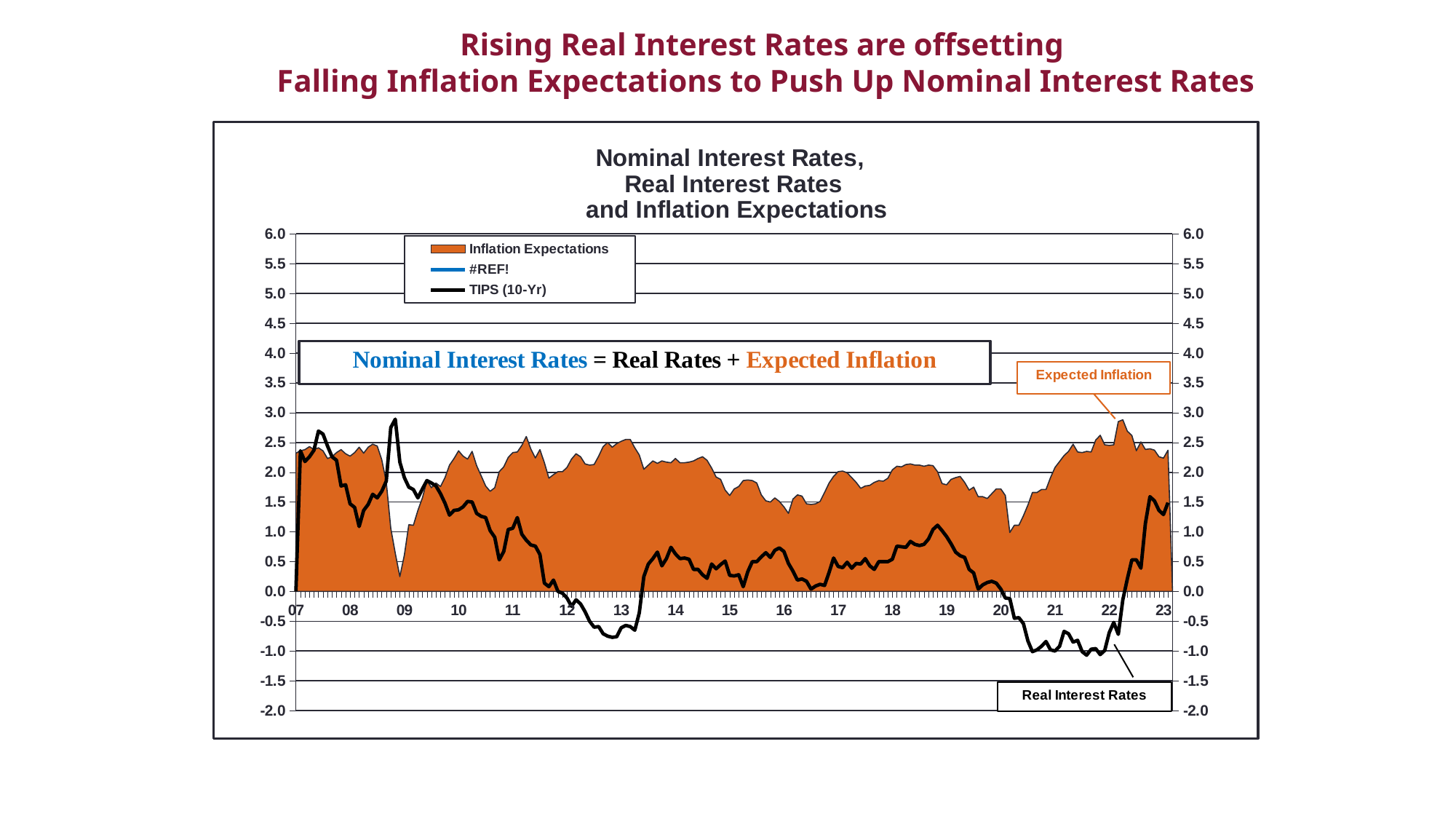
How many series does the legend list? 3 Which legend entry shows an error text instead of a series name? #REF! What kind of chart is shown on the slide? An area chart with a line series Is the TIPS (10-Yr) value in 2021 greater or less than 0.0? less Does the TIPS (10-Yr) line rise or fall between 2021 and 2023? rise Is the peak of Inflation Expectations in 2022 greater or less than 2.5? greater Does the Inflation Expectations area rise or fall between 2020 and 2022? rise How many year labels are shown on the x axis? 17 What is the title of the chart? Nominal Interest Rates, Real Interest Rates and Inflation Expectations